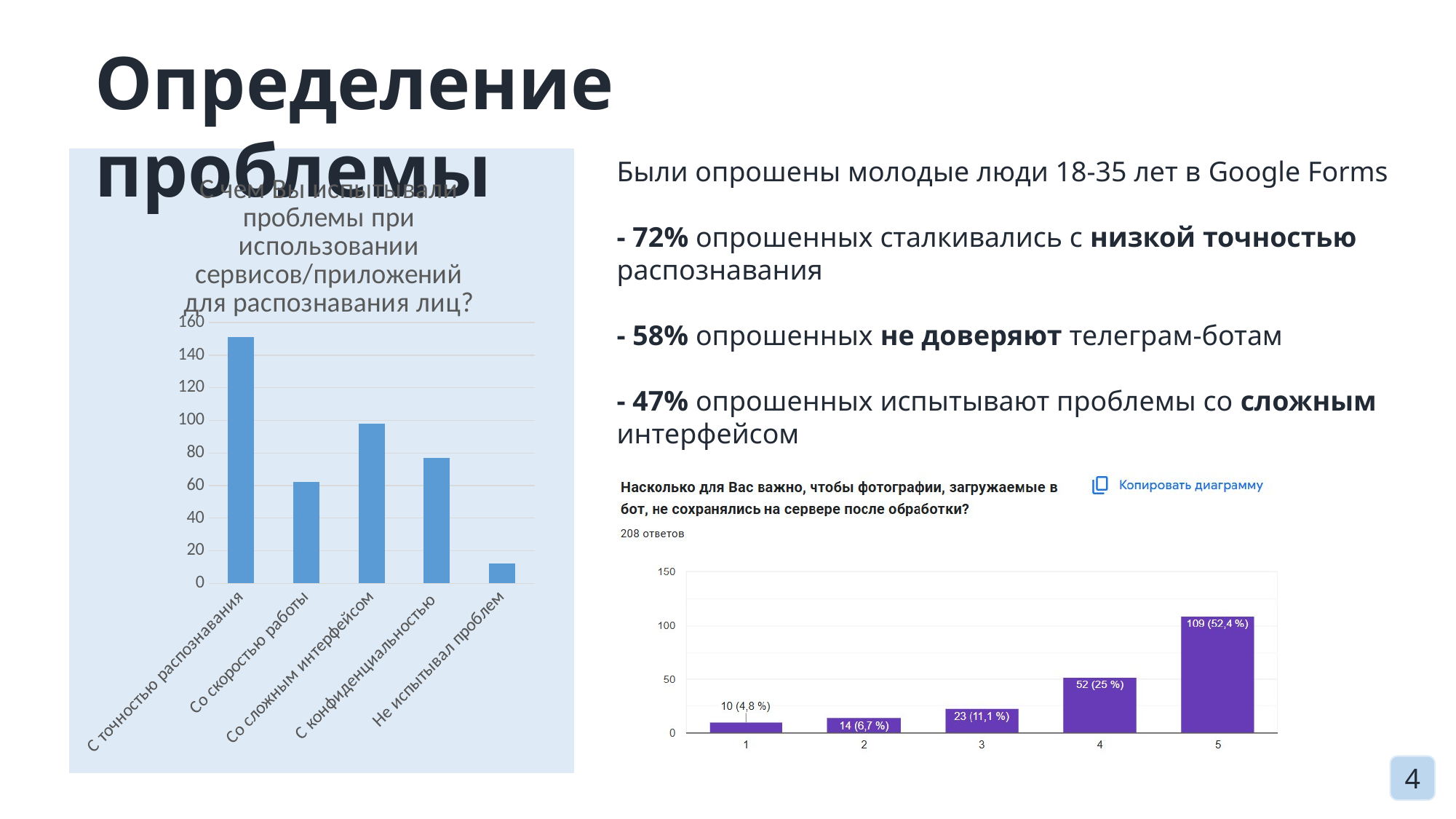
In the left-hand chart ("С чем Вы испытывали проблемы..."), which category has the highest bar? С точностью распознавания In the left-hand chart ("С чем Вы испытывали проблемы..."), is the value for "Со сложным интерфейсом" greater or less than 80? greater In the right-hand chart ("Насколько для Вас важно..."), what is the data label on the bar for category 5? 109 (52,4 %) In the left-hand chart ("С чем Вы испытывали проблемы..."), which category has the lowest bar? Не испытывал проблем In the right-hand chart ("Насколько для Вас важно..."), which category has the lowest value? 1 In the right-hand chart ("Насколько для Вас важно..."), how many categories are shown on the x axis? 5 In the right-hand chart ("Насколько для Вас важно..."), which category has the highest value? 5 In the right-hand chart ("Насколько для Вас важно..."), how many responses does the bar for category 3 represent? 23 In the right-hand chart ("Насколько для Вас важно..."), what percentage is shown for category 4? 25 % In the right-hand chart ("Насколько для Вас важно..."), what is the difference between the counts for category 5 and category 4? 57 In the right-hand chart ("Насколько для Вас важно..."), how many responses are reported in total under the title? 208 ответов In the left-hand chart ("С чем Вы испытывали проблемы..."), which is larger: the bar for "Со скоростью работы" or the bar for "С конфиденциальностью"? С конфиденциальностью